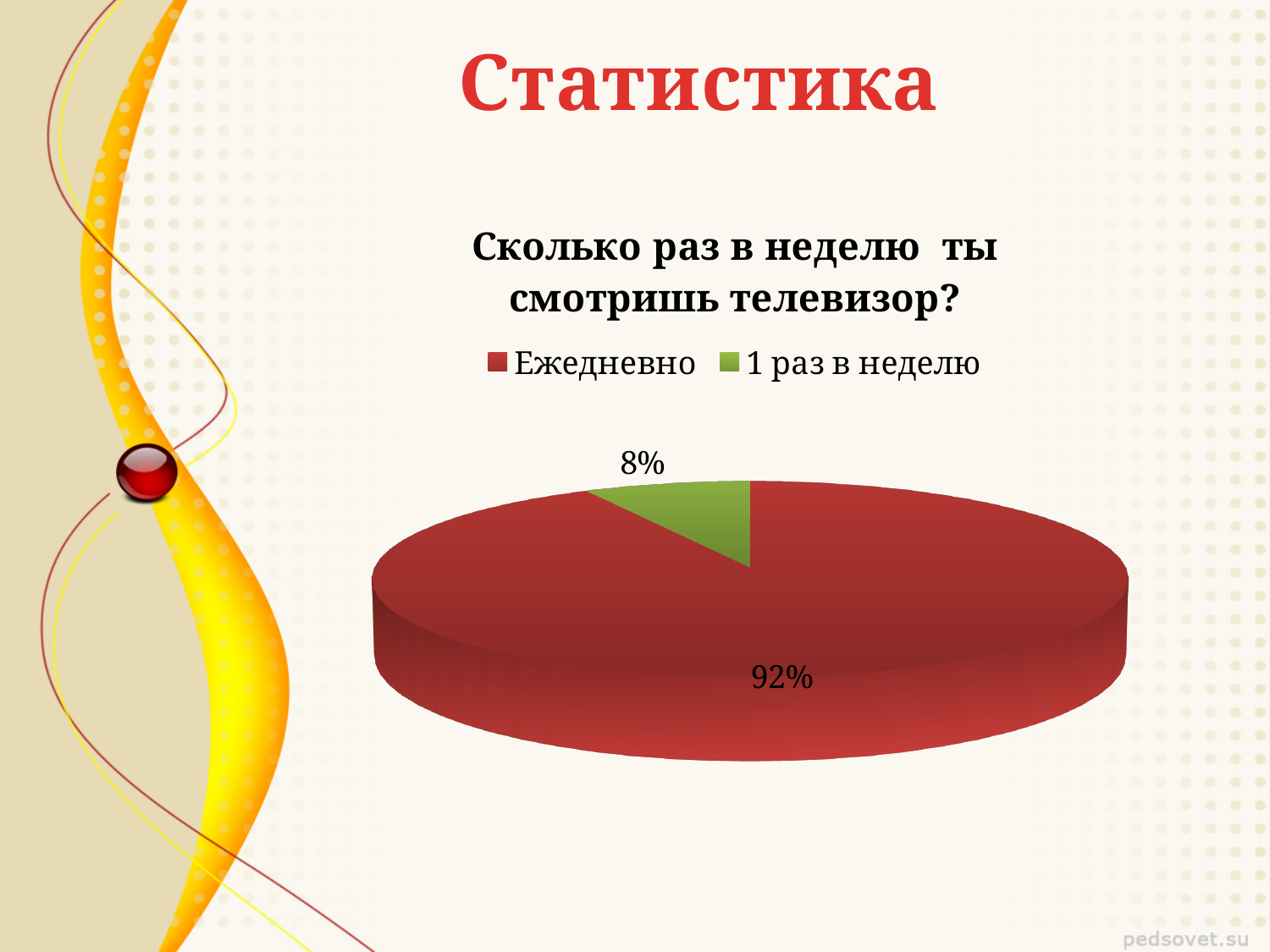
What percentage of respondents answered "Ежедневно"? 92% What share of the pie does the "Ежедневно" slice represent? 92% Which category has the largest share of the pie? Ежедневно How many entries does the legend list? 2 Which is larger: the share for "Ежедневно" or for "1 раз в неделю"? Ежедневно What percentage of respondents answered "1 раз в неделю"? 8% How many slices does the pie chart have? 2 What colour is the slice for "1 раз в неделю"? green What is the difference in percentage points between "Ежедневно" and "1 раз в неделю"? 84 What kind of chart is shown on the slide? pie chart Which category has the smallest share of the pie? 1 раз в неделю What is the chart's title? Сколько раз в неделю ты смотришь телевизор?